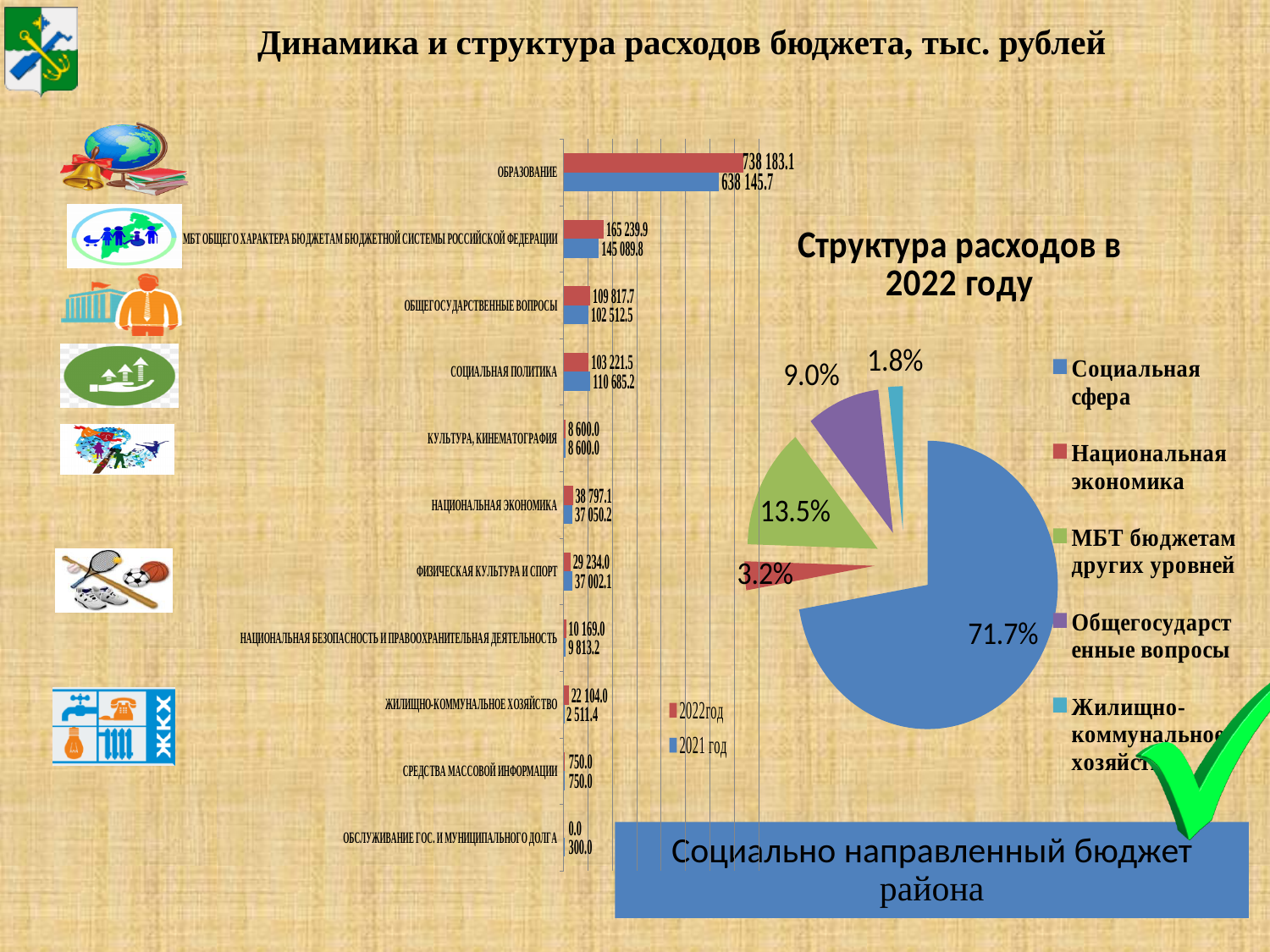
How many series does the legend of the bar chart on the left list? 2 In the pie chart 'Структура расходов в 2022 году', what share does Социальная сфера have? 71.7% In the pie chart 'Структура расходов в 2022 году', which category has the smallest share? Жилищно-коммунальное хозяйство How many categories does the bar chart on the left show? 11 In the bar chart on the left, what is the difference between the 2022 год and 2021 год values for ОБРАЗОВАНИЕ? 100 037.4 What type of chart is the chart on the left of the slide? Bar chart In the bar chart on the left, what is the 2022 год value for ЖИЛИЩНО-КОММУНАЛЬНОЕ ХОЗЯЙСТВО? 22 104.0 In the bar chart on the left, what is the 2021 год value for СОЦИАЛЬНАЯ ПОЛИТИКА? 110 685.2 In the bar chart on the left, what is the 2022 год value for ОБРАЗОВАНИЕ? 738 183.1 In the bar chart on the left, which category has the lowest 2022 год value? ОБСЛУЖИВАНИЕ ГОС. И МУНИЦИПАЛЬНОГО ДОЛГА In the bar chart on the left, which is larger for ФИЗИЧЕСКАЯ КУЛЬТУРА И СПОРТ: the 2022 год value or the 2021 год value? 2021 год In the bar chart on the left, which category has the highest 2022 год value? ОБРАЗОВАНИЕ